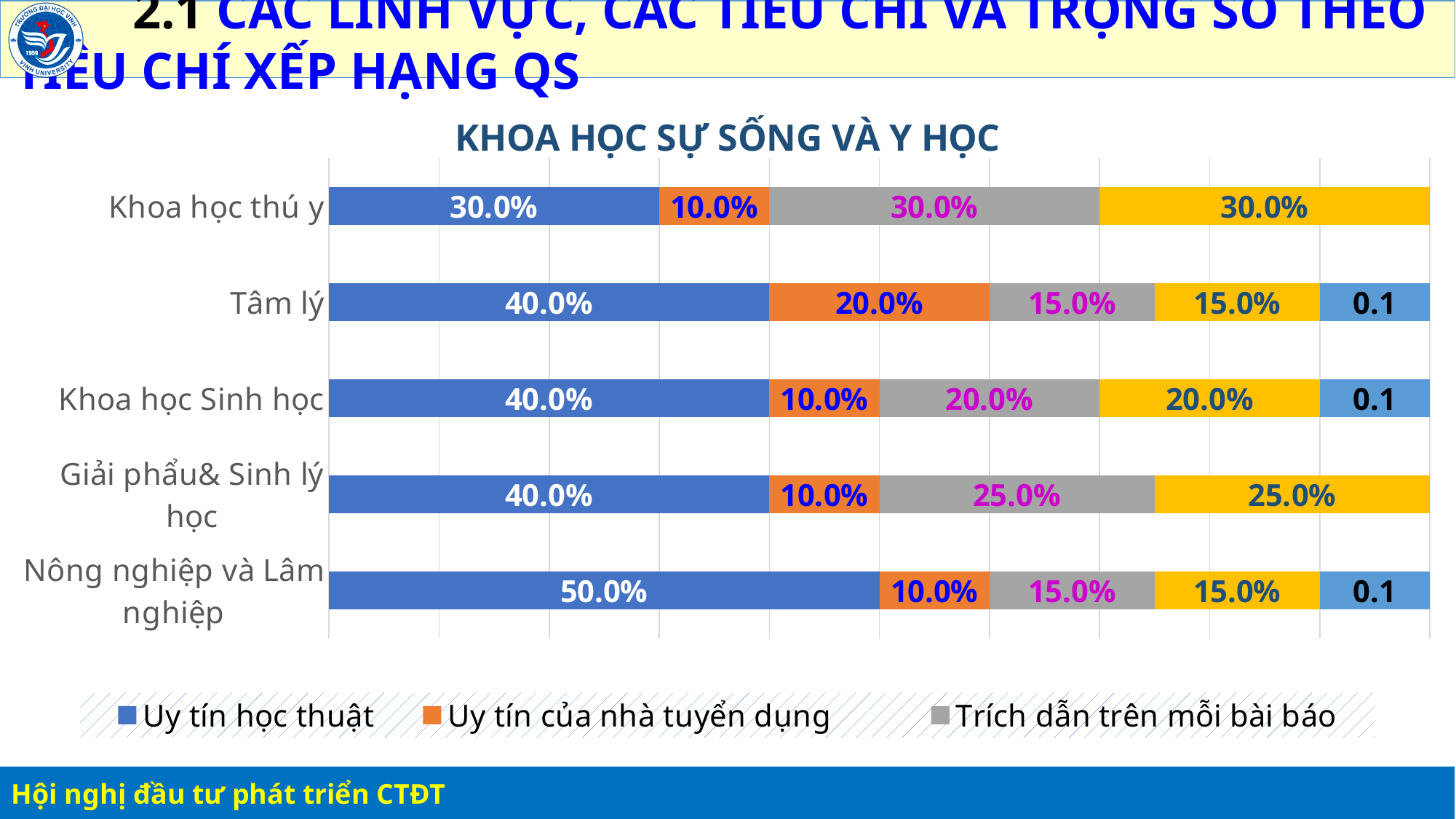
What is the value of Uy tín của nhà tuyển dụng for Tâm lý? 20.0% Which category has the lowest value for Uy tín học thuật? Khoa học thú y What kind of chart is shown on the slide? Stacked bar chart What is the title of the chart? KHOA HỌC SỰ SỐNG VÀ Y HỌC Which category has the highest value for Uy tín của nhà tuyển dụng? Tâm lý What is the value of Uy tín học thuật for Nông nghiệp và Lâm nghiệp? 50.0% What is the difference in Uy tín học thuật between Nông nghiệp và Lâm nghiệp and Khoa học thú y? 20.0% Which is larger for Trích dẫn trên mỗi bài báo: Khoa học thú y or Tâm lý? Khoa học thú y How many categories are shown on the chart? 5 What is the value of Uy tín học thuật for Khoa học thú y? 30.0% What is the value of Trích dẫn trên mỗi bài báo for Giải phẩu& Sinh lý học? 25.0% Which category has the highest value for Uy tín học thuật? Nông nghiệp và Lâm nghiệp